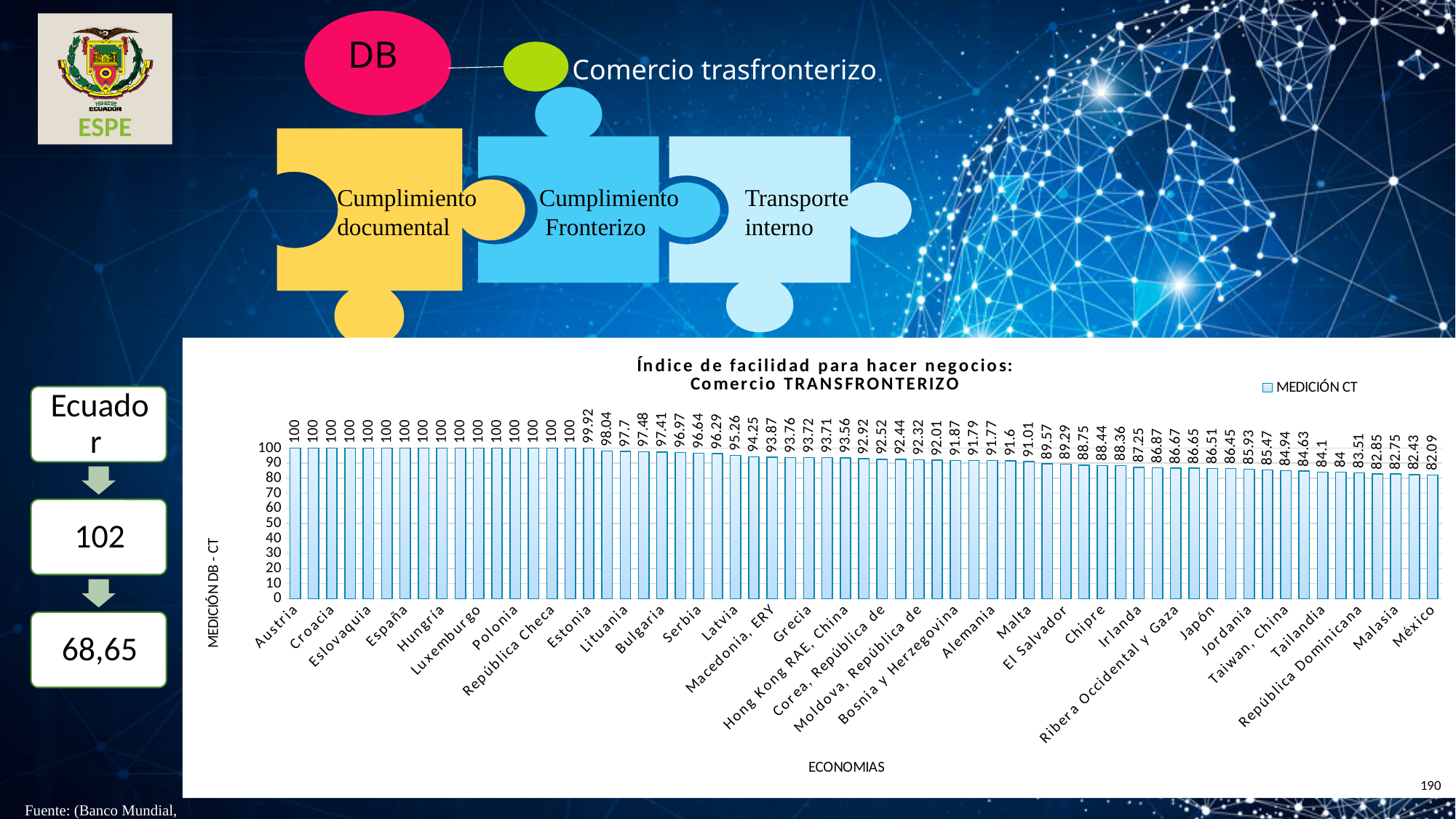
What kind of chart is shown on the slide? bar chart Is the value for Malta greater or less than 90? greater Do the values rise or fall moving from left to right along the x axis? fall What is the value for México? 82.09 What is the title of the chart? Índice de facilidad para hacer negocios: Comercio TRANSFRONTERIZO What is the difference between the value for Austria and the value for México? 17.91 How many series does the chart legend list? 1 Which economy has the lowest value in the chart? México What is the series name shown in the chart legend? MEDICIÓN CT Is the value for Alemania greater or less than 90? greater Is the value for Japón greater or less than 80? greater What is the value for Austria? 100